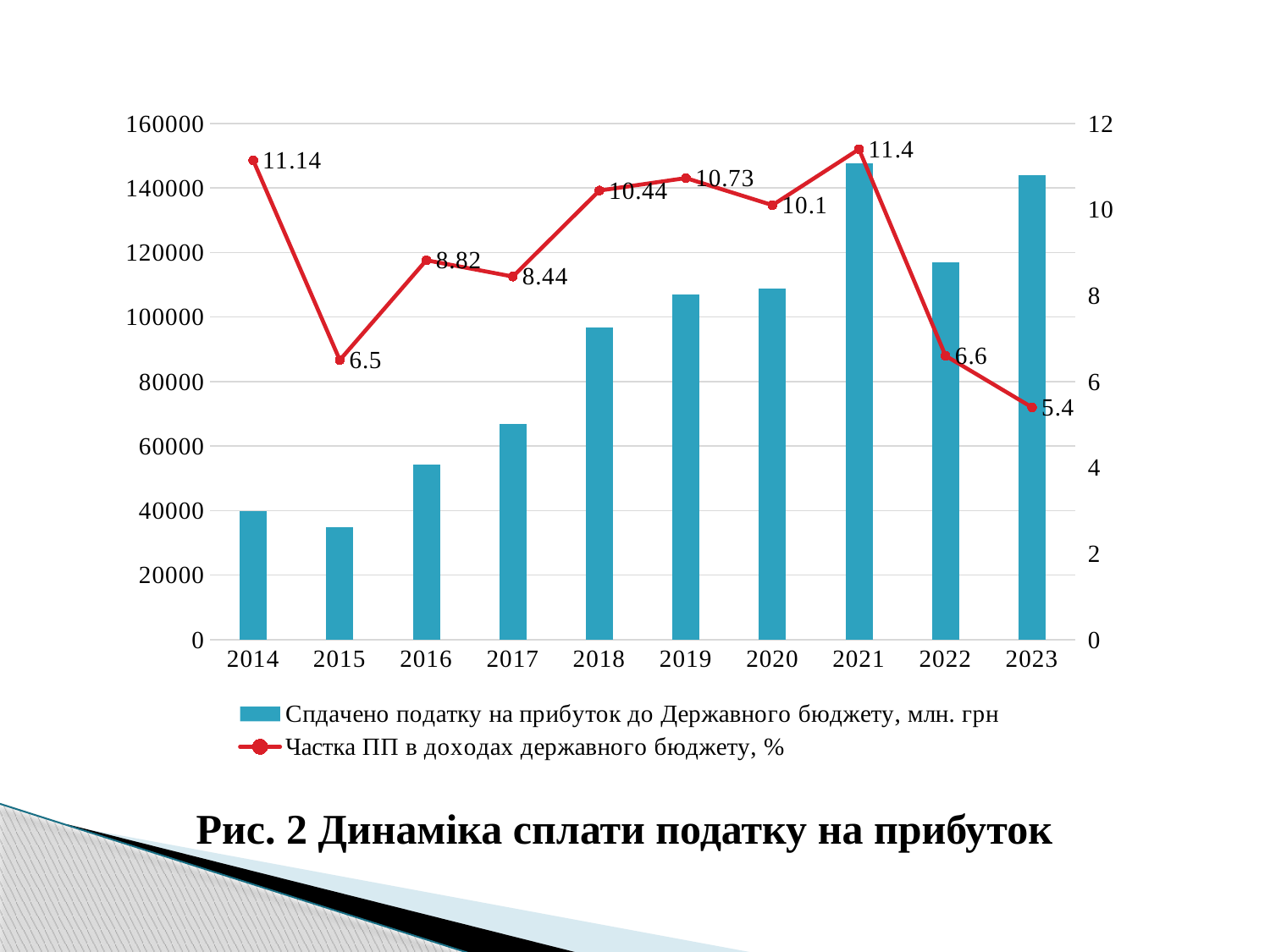
How many years are shown on the x axis of the chart? 10 What is the value of the line series (Частка ПП в доходах державного бюджету, %) for 2021? 11.4 Which year has a larger value for the line series (Частка ПП в доходах державного бюджету, %): 2018 or 2019? 2019 How many series does the legend list? 2 What is the difference between the line series values for 2021 and 2022? 4.8 Do the bar values (Спдачено податку на прибуток до Державного бюджету, млн. грн) rise or fall from 2014 to 2021? rise What is the value of the line series (Частка ПП в доходах державного бюджету, %) for 2023? 5.4 In which year is the share of corporate income tax in state budget revenues (line series) the highest? 2021 In which year is the share of corporate income tax in state budget revenues (line series) the lowest? 2023 What is the share of corporate income tax in state budget revenues (Частка ПП в доходах державного бюджету, %) in 2014? 11.14 Is the bar value (Спдачено податку на прибуток до Державного бюджету, млн. грн) for 2015 greater or less than 40000? less Is the bar value (Спдачено податку на прибуток до Державного бюджету, млн. грн) for 2021 greater or less than 140000? greater